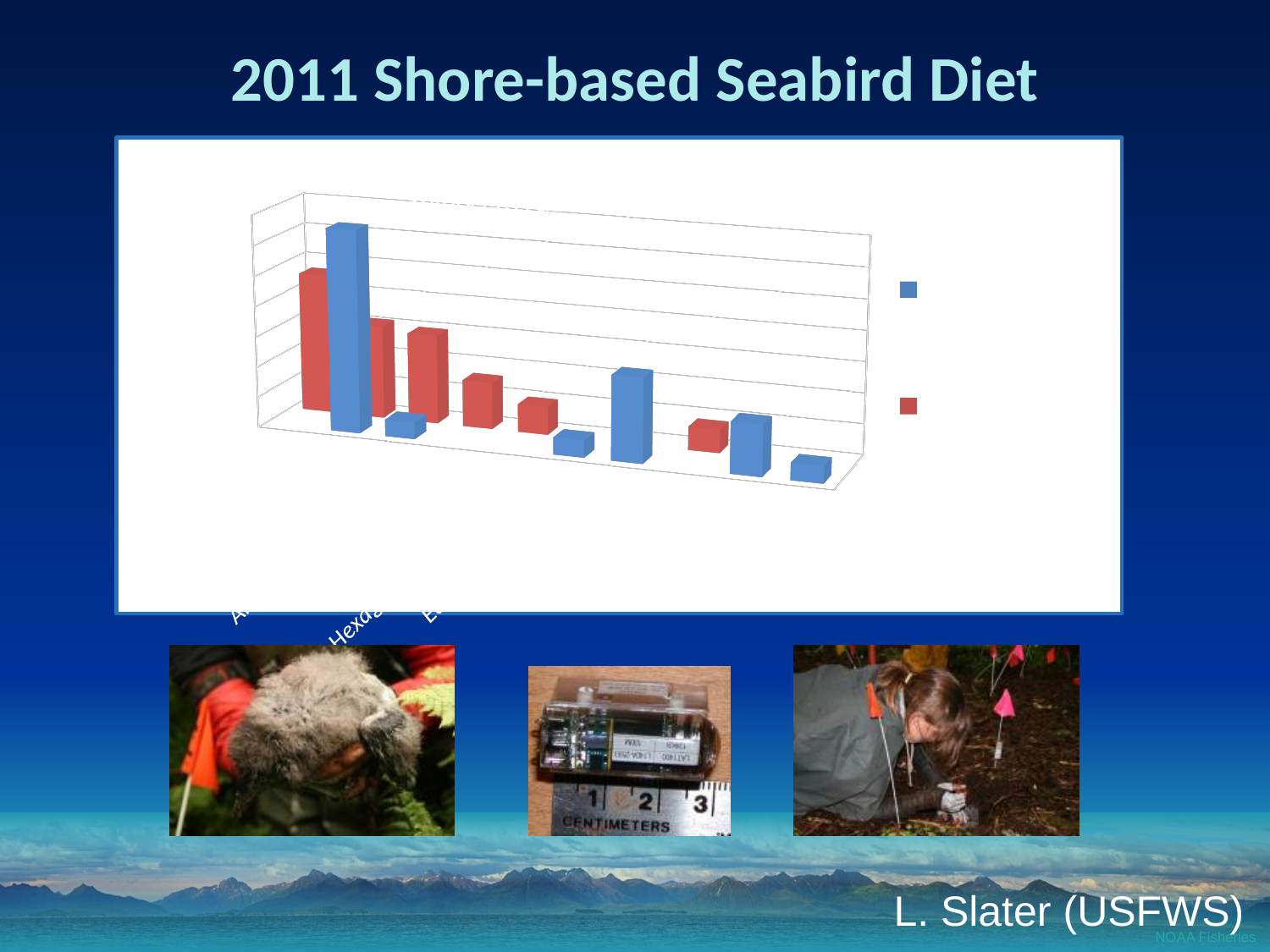
What colours are the two series in the chart? blue and red How many series does the chart's legend list? 2 What kind of chart is shown on the slide? bar chart Is the tallest bar in the chart blue or red? blue